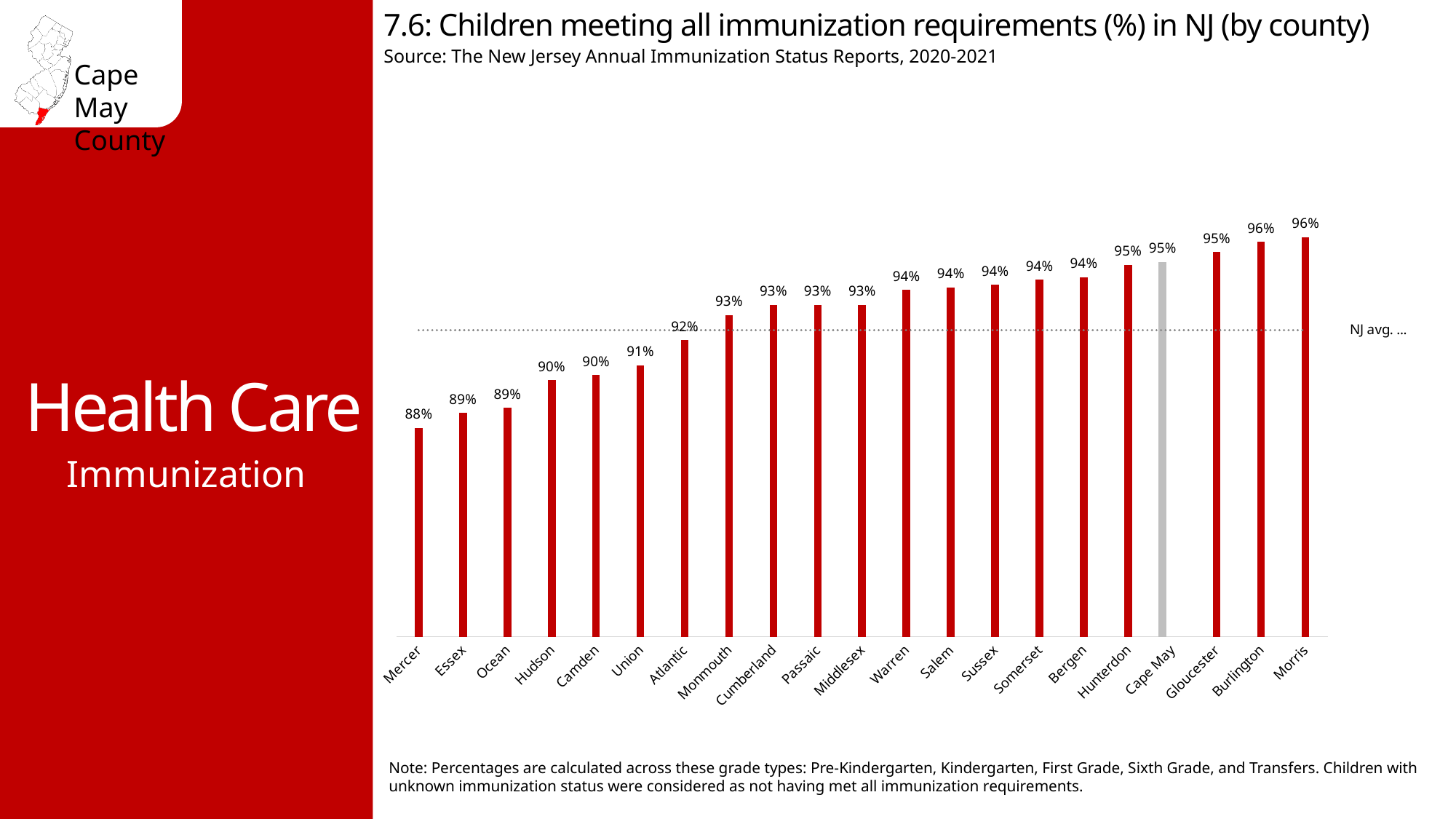
Do the values rise or fall moving from left to right across the counties? Rise What is the difference in percentage points between Morris County and Mercer County? 8 percentage points What percentage is shown for Atlantic County? 92% How many percentage points higher is Cape May County than Mercer County? 7 percentage points What is the value for Hunterdon County? 95% How many counties are shown on the chart? 21 Which county has the lowest percentage of children meeting all immunization requirements? Mercer Which has a higher value, Cape May or Atlantic? Cape May What kind of chart is used on this slide? Bar chart What percentage of children in Cape May County met all immunization requirements? 95% Which has a higher value, Union or Warren? Warren What is the value shown for Mercer County? 88%